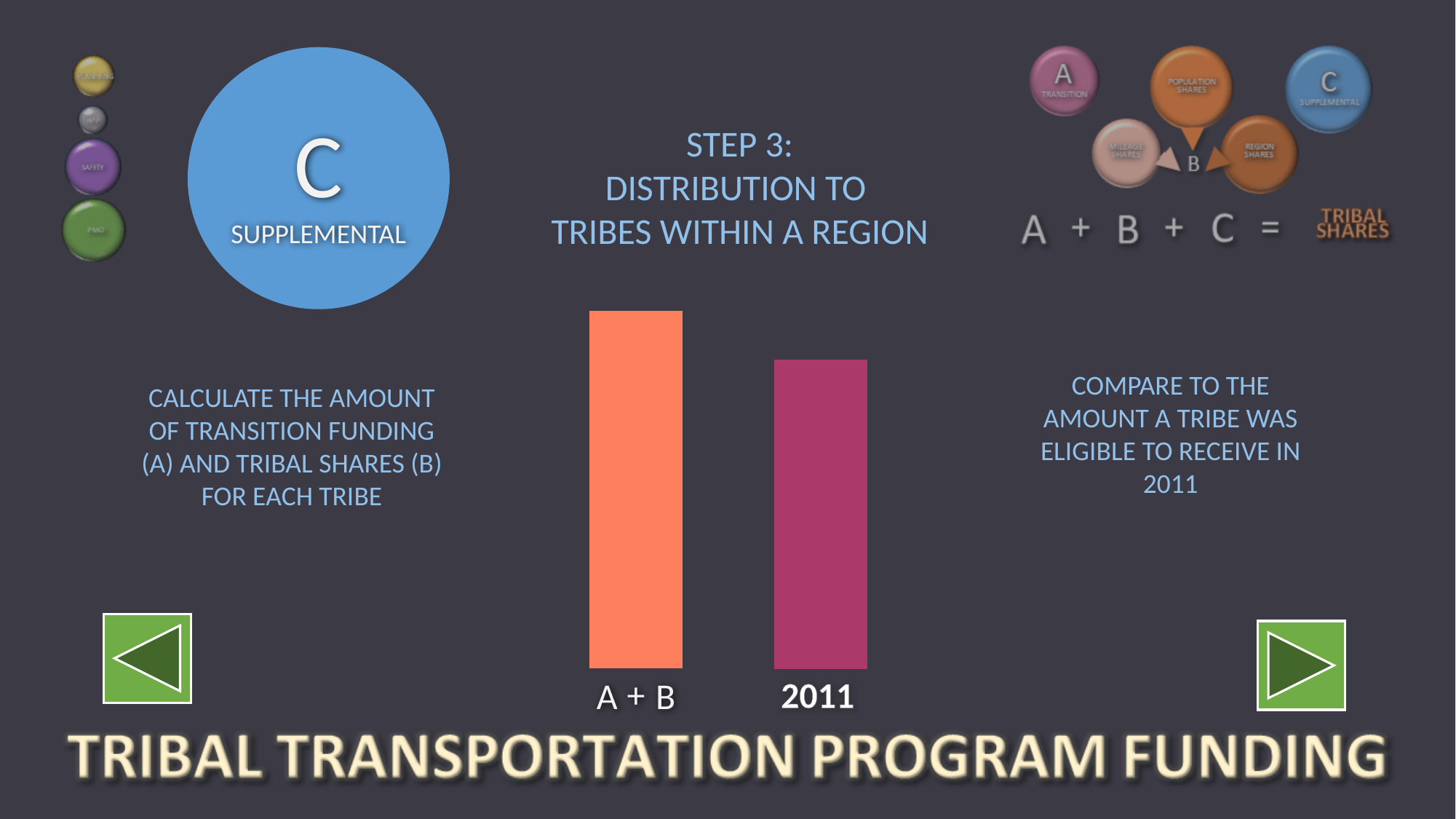
How many bars does the chart show? 2 What colour is the A + B bar? orange What kind of chart is shown in the centre of the slide? bar chart What are the labels of the two bars in the chart? A + B and 2011 Which category has the highest bar? A + B Which bar is taller, A + B or 2011? A + B Which category has the lowest bar? 2011